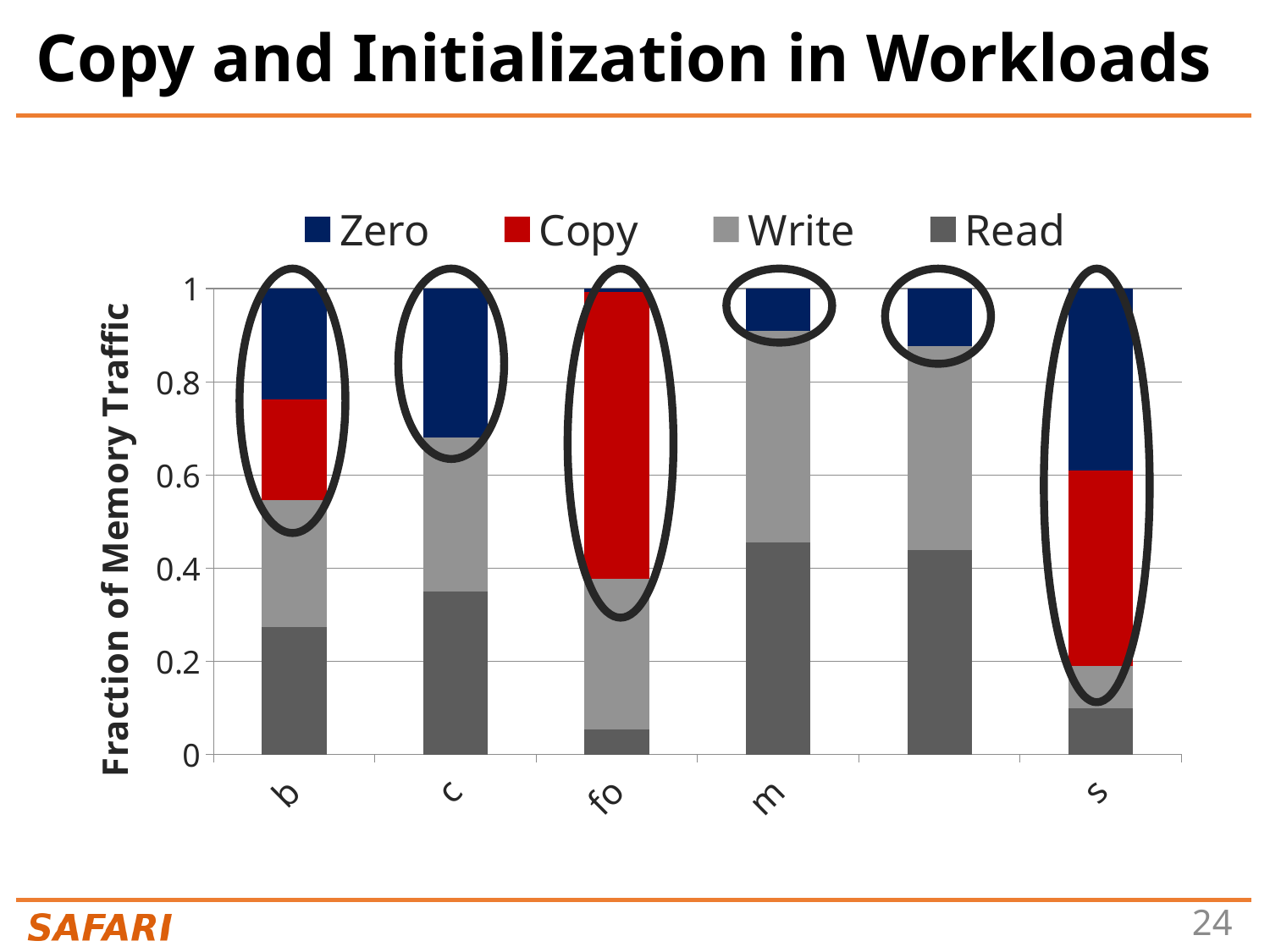
Which colour represents the Copy series in the legend? Red Which workload has the smallest Read segment? fo Is the Read fraction for workload m greater or less than 0.4? greater Which workload has a larger Zero segment, b or c? c Which workload has the largest Zero segment? s What kind of chart is shown on the slide? Stacked bar chart How many series does the legend list? 4 What is the y-axis title of the chart? Fraction of Memory Traffic What is the total height of the stacked bar for workload b? 1 Which workload has the largest Copy segment? fo Is the Read fraction for workload b greater or less than 0.4? less How many bars are plotted in the chart? 6